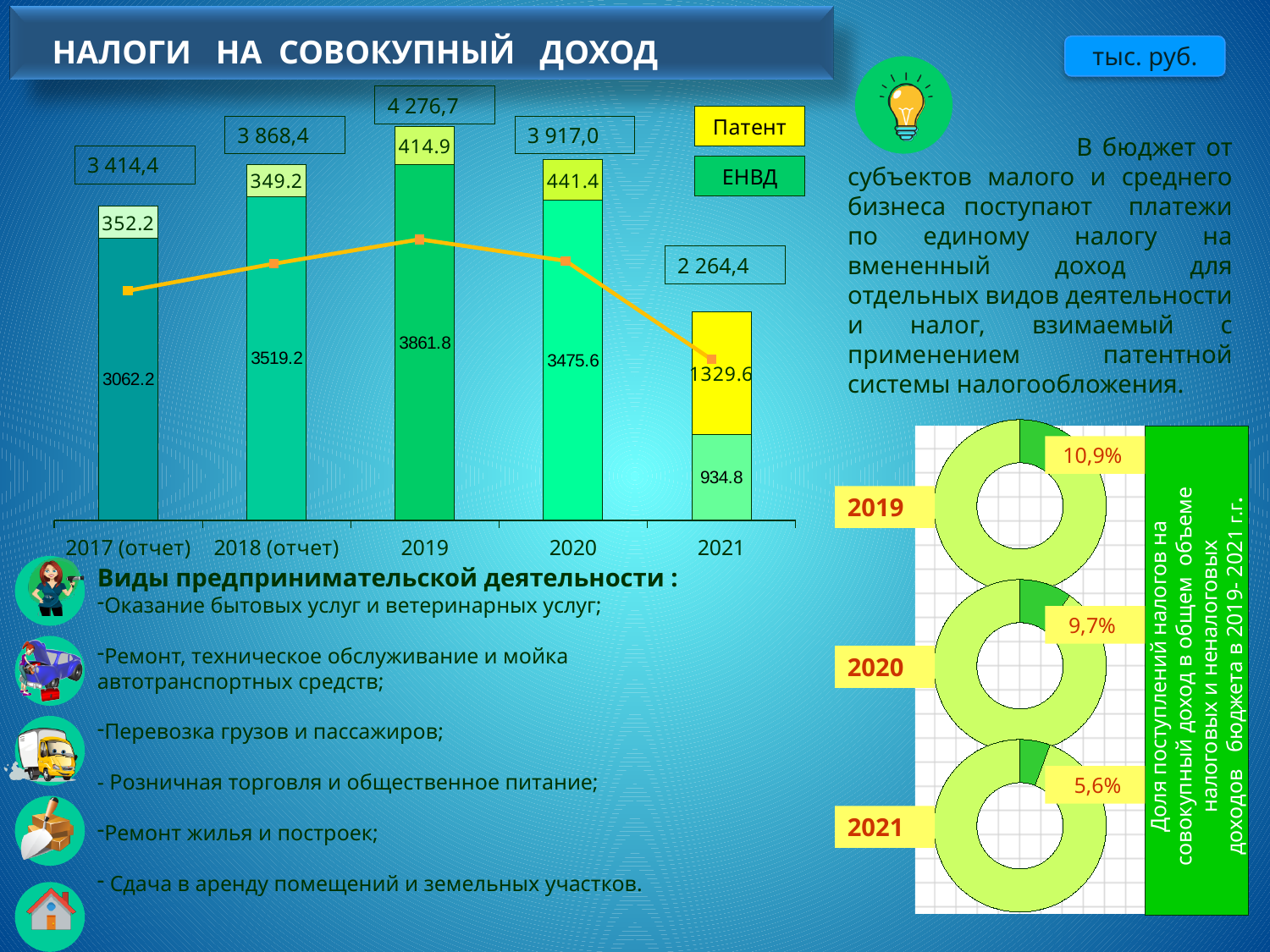
In the donut charts on the right of the slide, do the shares rise or fall from 2019 to 2021? fall In the bar chart 'НАЛОГИ НА СОВОКУПНЫЙ ДОХОД', what is the difference between the ЕНВД values for 2019 and 2020? 386.2 In the bar chart 'НАЛОГИ НА СОВОКУПНЫЙ ДОХОД', which year has the highest Патент value? 2021 How many year categories are shown on the x axis of the bar chart 'НАЛОГИ НА СОВОКУПНЫЙ ДОХОД'? 5 In the donut charts on the right of the slide, what share is shown for 2020? 9,7% What kind of chart is used for 'НАЛОГИ НА СОВОКУПНЫЙ ДОХОД'? stacked bar chart with a line In the bar chart 'НАЛОГИ НА СОВОКУПНЫЙ ДОХОД', what is the Патент value for 2021? 1329.6 How many series does the legend of the bar chart 'НАЛОГИ НА СОВОКУПНЫЙ ДОХОД' list? 2 In the bar chart 'НАЛОГИ НА СОВОКУПНЫЙ ДОХОД', what is the ЕНВД value for 2019? 3861.8 In the bar chart 'НАЛОГИ НА СОВОКУПНЫЙ ДОХОД', which year has the lowest ЕНВД value? 2021 In the bar chart 'НАЛОГИ НА СОВОКУПНЫЙ ДОХОД', what total is shown above the bar for 2019? 4 276,7 In the bar chart 'НАЛОГИ НА СОВОКУПНЫЙ ДОХОД', is the Патент value for 2020 larger or smaller than the Патент value for 2018 (отчет)? larger